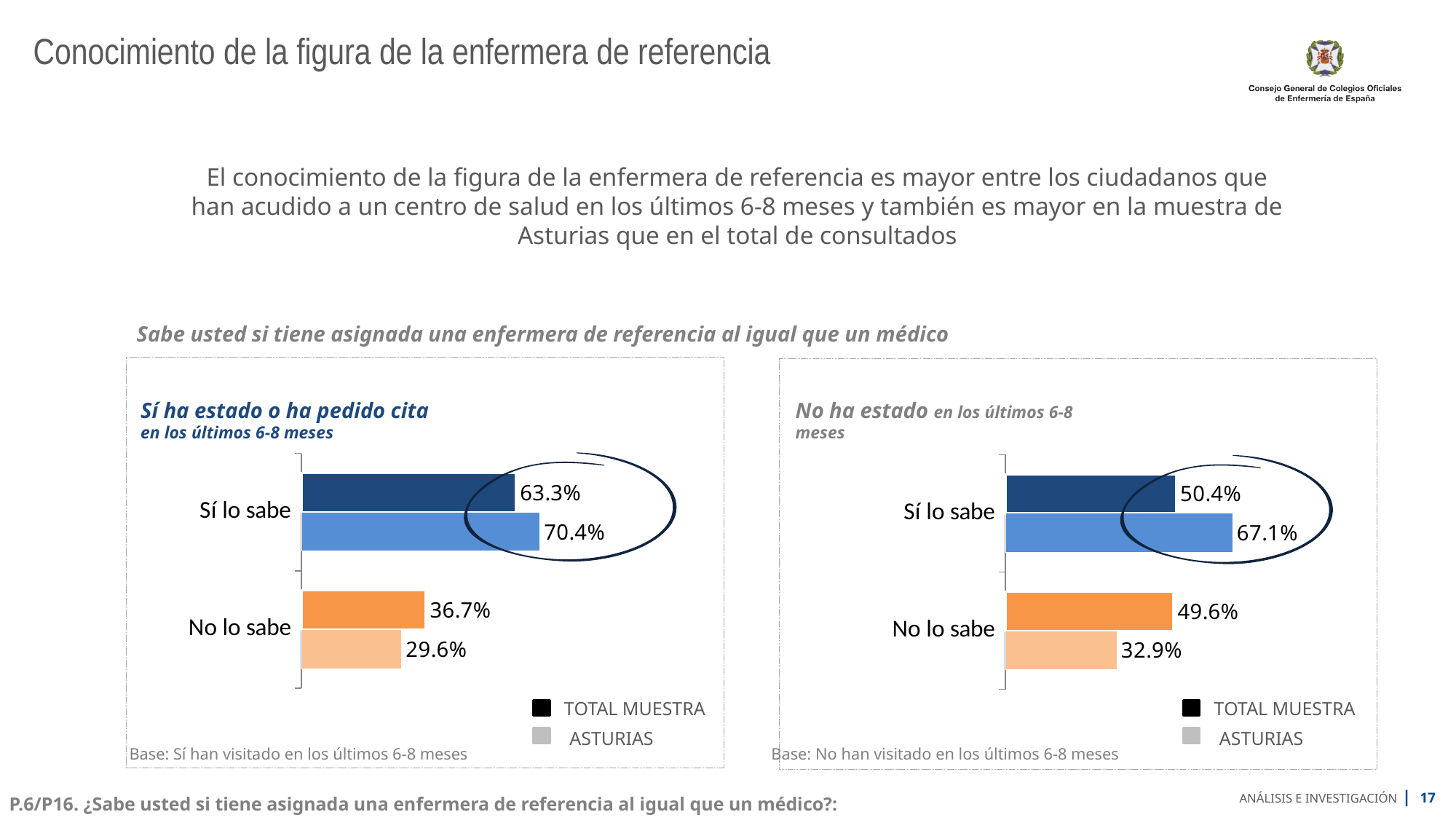
What is the base noted under the left chart? Sí han visitado en los últimos 6-8 meses What kind of chart is used in the right chart (No ha estado en los últimos 6-8 meses)? Bar chart How many series does the legend of the left chart list? 2 In the right chart (No ha estado en los últimos 6-8 meses), which is larger for 'No lo sabe': TOTAL MUESTRA or ASTURIAS? TOTAL MUESTRA In the left chart (Sí ha estado o ha pedido cita en los últimos 6-8 meses), what is the value for 'Sí lo sabe' in the TOTAL MUESTRA series? 63.3% In the right chart (No ha estado en los últimos 6-8 meses), what is the value for 'No lo sabe' in the TOTAL MUESTRA series? 49.6% In the right chart (No ha estado en los últimos 6-8 meses), what is the difference between the ASTURIAS and TOTAL MUESTRA values for 'Sí lo sabe'? 16.7% In the left chart (Sí ha estado o ha pedido cita en los últimos 6-8 meses), what is the difference between the ASTURIAS and TOTAL MUESTRA values for 'Sí lo sabe'? 7.1% In the right chart (No ha estado en los últimos 6-8 meses), which bar has the lowest value? No lo sabe, ASTURIAS (32.9%) In the right chart (No ha estado en los últimos 6-8 meses), what is the value for 'Sí lo sabe' in the ASTURIAS series? 67.1% In the left chart (Sí ha estado o ha pedido cita en los últimos 6-8 meses), which bar has the highest value? Sí lo sabe, ASTURIAS (70.4%) In the left chart (Sí ha estado o ha pedido cita en los últimos 6-8 meses), what is the value for 'No lo sabe' in the ASTURIAS series? 29.6%